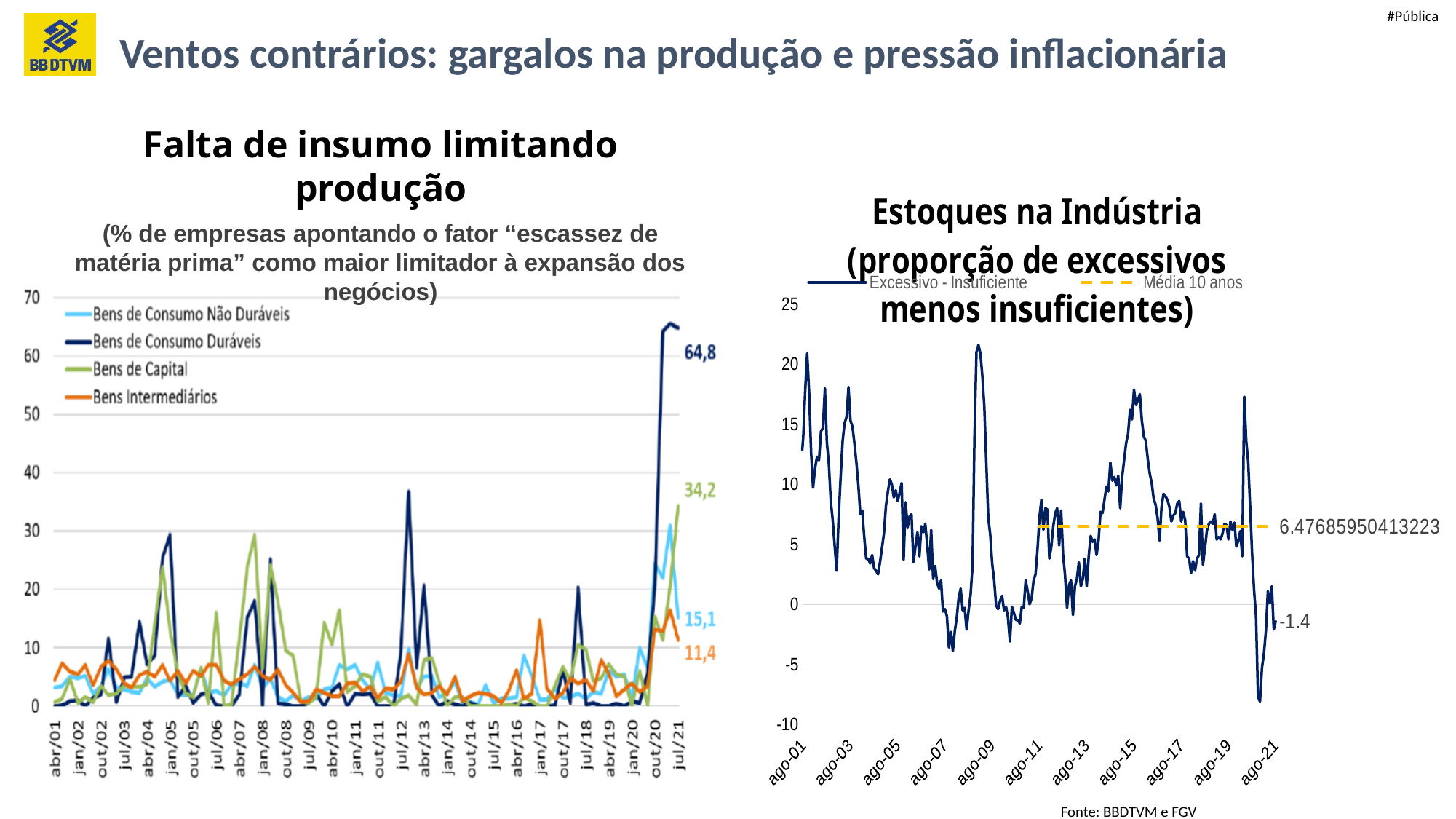
What kind of chart is the right chart 'Estoques na Indústria'? Line chart In the left chart 'Falta de insumo limitando produção', which final value is larger: Bens de Consumo Não Duráveis or Bens Intermediários? Bens de Consumo Não Duráveis In the left chart 'Falta de insumo limitando produção', what is the latest value labelled for Bens Intermediários? 11,4 In the right chart 'Estoques na Indústria', what value is labelled for the Média 10 anos line? 6.47685950413223 In the left chart 'Falta de insumo limitando produção', what is the latest value labelled for Bens de Capital? 34,2 In the left chart 'Falta de insumo limitando produção', what is the difference between the final values of Bens de Consumo Duráveis (64,8) and Bens de Capital (34,2)? 30,6 In the left chart 'Falta de insumo limitando produção', what is the latest value labelled for Bens de Consumo Duráveis? 64,8 In the left chart 'Falta de insumo limitando produção', which series has the lowest labelled value at the end of the period? Bens Intermediários How many series does the legend of the left chart 'Falta de insumo limitando produção' list? 4 In the left chart 'Falta de insumo limitando produção', which series has the highest value at the end of the period (jul/21)? Bens de Consumo Duráveis How many series does the legend of the right chart 'Estoques na Indústria' list? 2 In the right chart 'Estoques na Indústria', what is the last value labelled on the Excessivo - Insuficiente line? -1.4